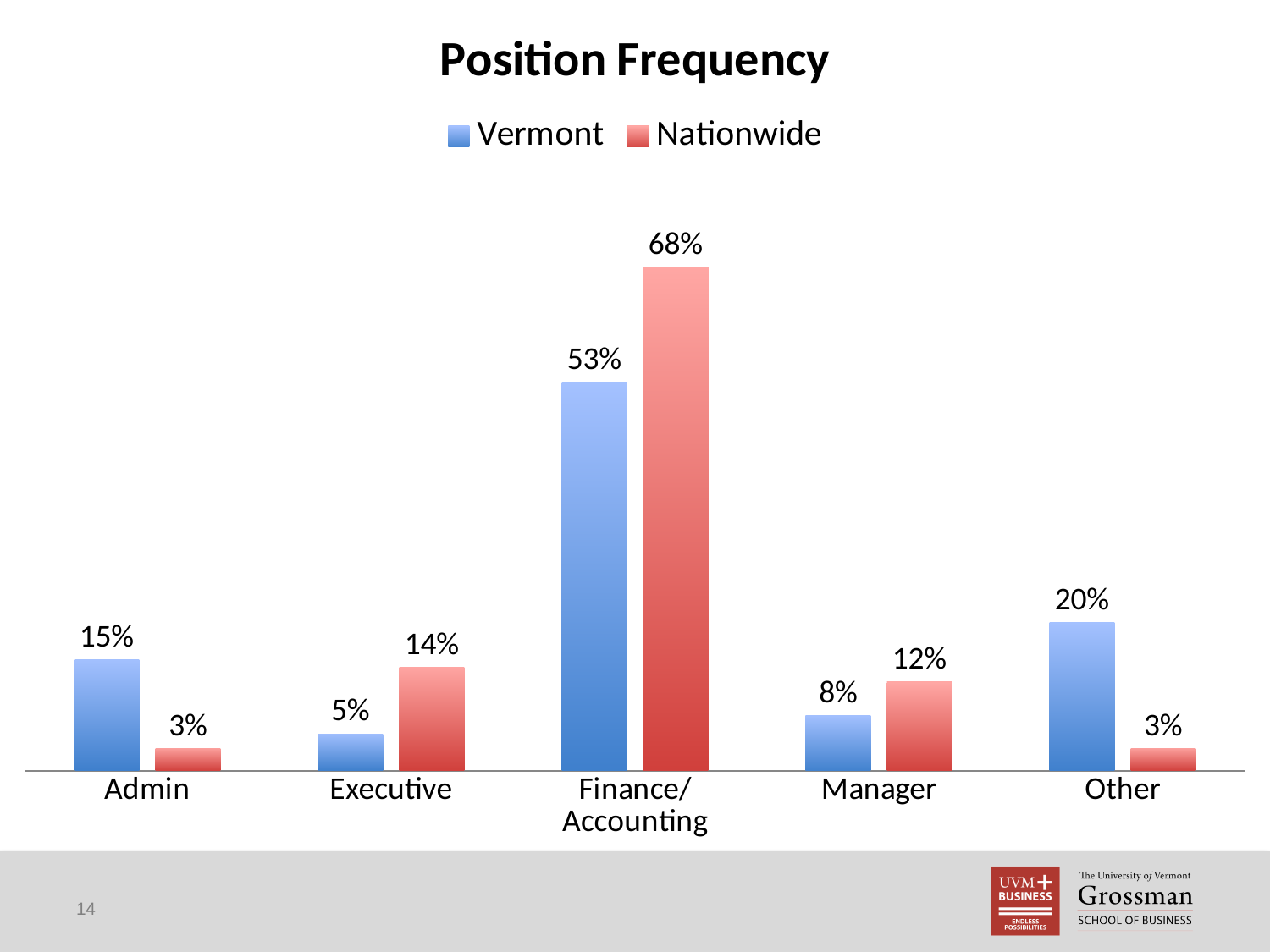
How many series does the legend list? 2 What is the difference between the Nationwide and Vermont values for Finance/Accounting? 15% What is the Nationwide value for Manager? 12% What is the Vermont value for Finance/Accounting? 53% What is the Nationwide value for Executive? 14% Which is larger for Manager, the Vermont value or the Nationwide value? Nationwide How many categories are shown on the x axis? 5 What is the Vermont value for Other? 20% Which category has the lowest Vermont value? Executive What kind of chart is shown on the slide? Bar chart What is the difference between the Vermont and Nationwide values for Admin? 12% Which category has the highest Nationwide value? Finance/Accounting